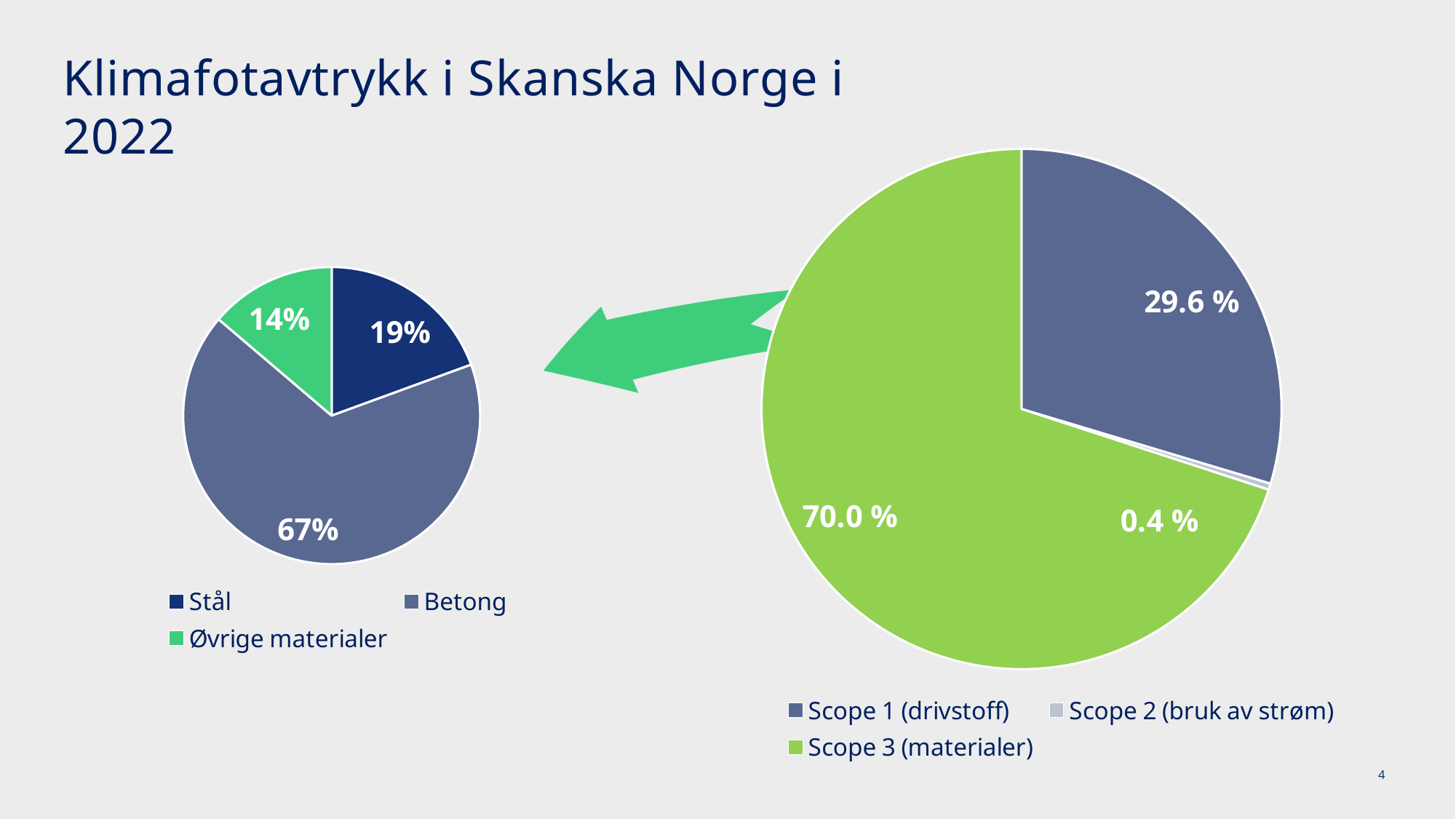
On the right-hand pie chart, what share is shown for Scope 2 (bruk av strøm)? 0.4 % On the right-hand pie chart, what is the difference between the shares of Scope 3 (materialer) and Scope 1 (drivstoff)? 40.4 % On the left-hand pie chart, which category has the smallest slice? Øvrige materialer On the right-hand pie chart, what share is shown for Scope 1 (drivstoff)? 29.6 % On the left-hand pie chart, what share is shown for Stål? 19% What kind of chart is the left-hand chart? Pie chart How many categories does the legend of the right-hand pie chart list? 3 On the left-hand pie chart, what share is shown for Betong? 67% On the left-hand pie chart, what is the difference between the shares of Stål and Øvrige materialer? 5% On the right-hand pie chart, what share is shown for Scope 3 (materialer)? 70.0 % On the left-hand pie chart, which is larger: the share for Stål or the share for Øvrige materialer? Stål On the right-hand pie chart, which category has the largest slice? Scope 3 (materialer)